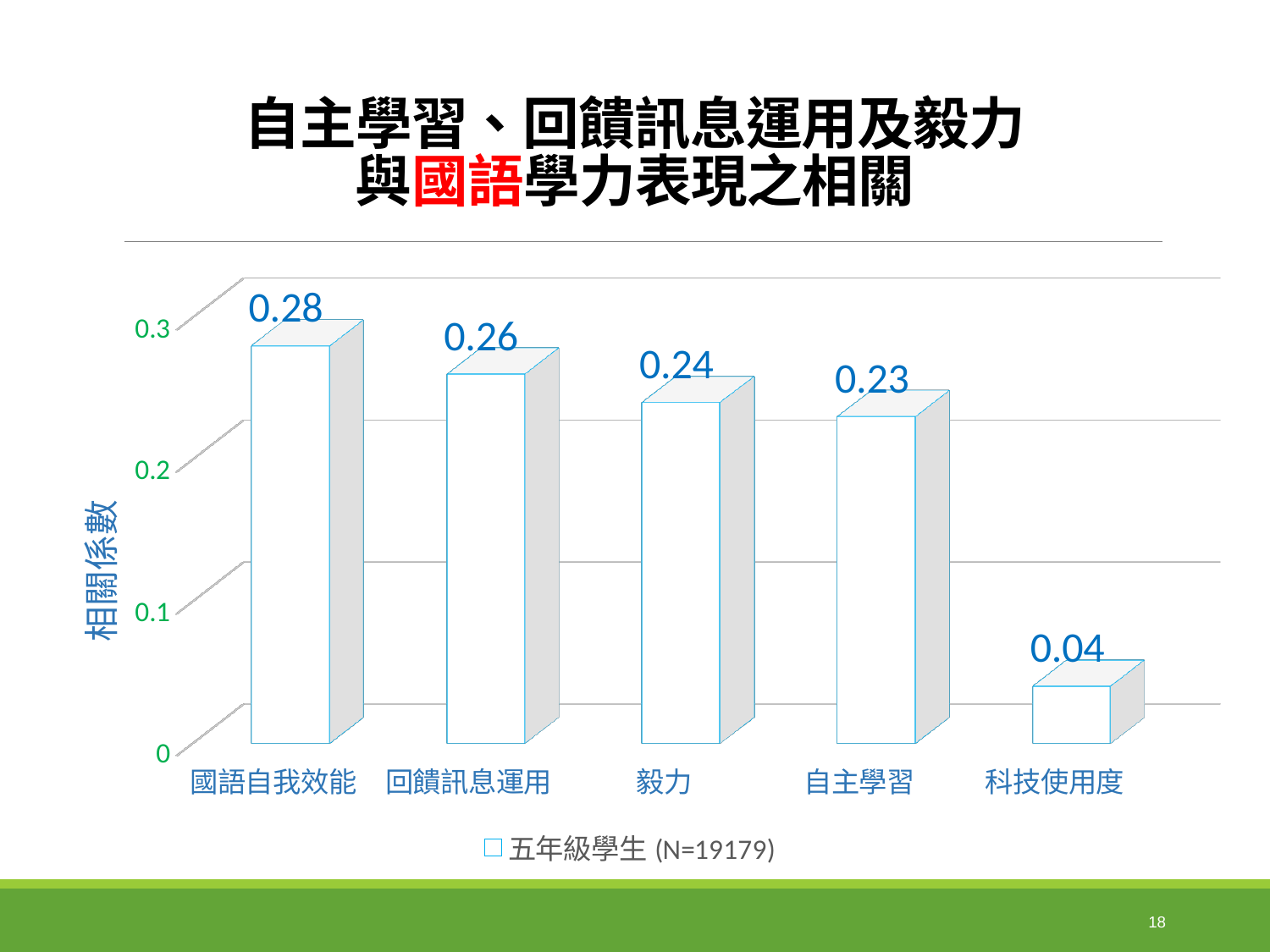
What is the difference between the values for 國語自我效能 and 自主學習? 0.05 How many categories are shown on the x axis? 5 What is the difference between the values for 回饋訊息運用 and 科技使用度? 0.22 What kind of chart is shown on the slide? bar chart Which category has the lowest correlation coefficient? 科技使用度 How many series does the legend list? 1 What is the correlation coefficient for 國語自我效能? 0.28 What is the value shown for 科技使用度? 0.04 Which is larger, the value for 回饋訊息運用 or the value for 自主學習? 回饋訊息運用 What is the value shown for 毅力? 0.24 Which category has the highest correlation coefficient? 國語自我效能 What is the legend entry for the series? 五年級學生 (N=19179)